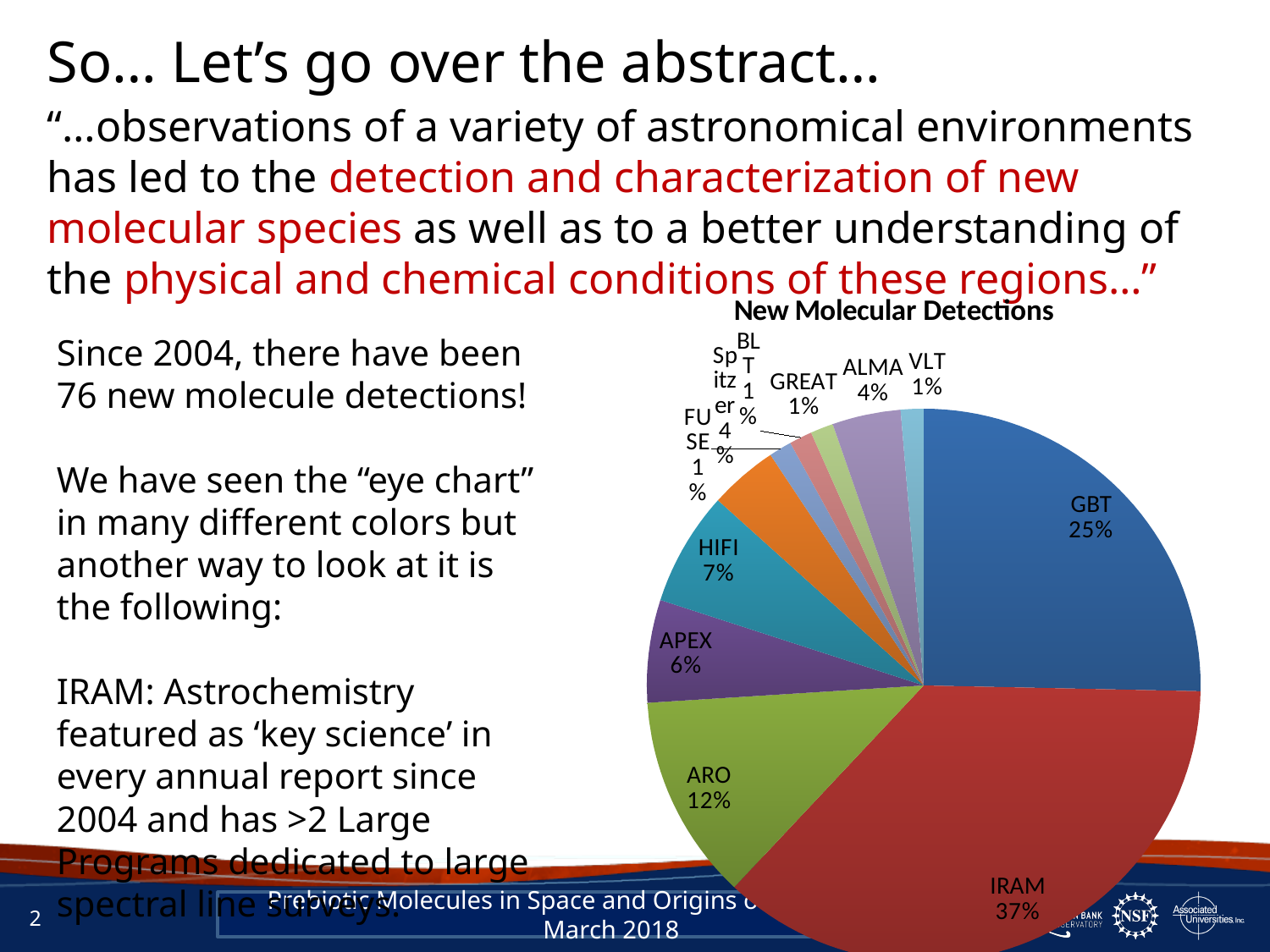
What percentage is shown for ALMA? 4% What is the combined share of IRAM and GBT? 62% Which is larger, the share for APEX or the share for HIFI? HIFI What is the difference in percentage points between the IRAM and GBT slices? 12 What kind of chart is shown on the slide? pie chart How many slices does the pie chart have? 11 Which facility has the largest slice of the pie? IRAM What is the title of the chart? New Molecular Detections What share of new molecular detections is attributed to GBT? 25% What percentage is shown for HIFI? 7% What share of new molecular detections is attributed to IRAM? 37% What percentage of the pie does ARO account for? 12%